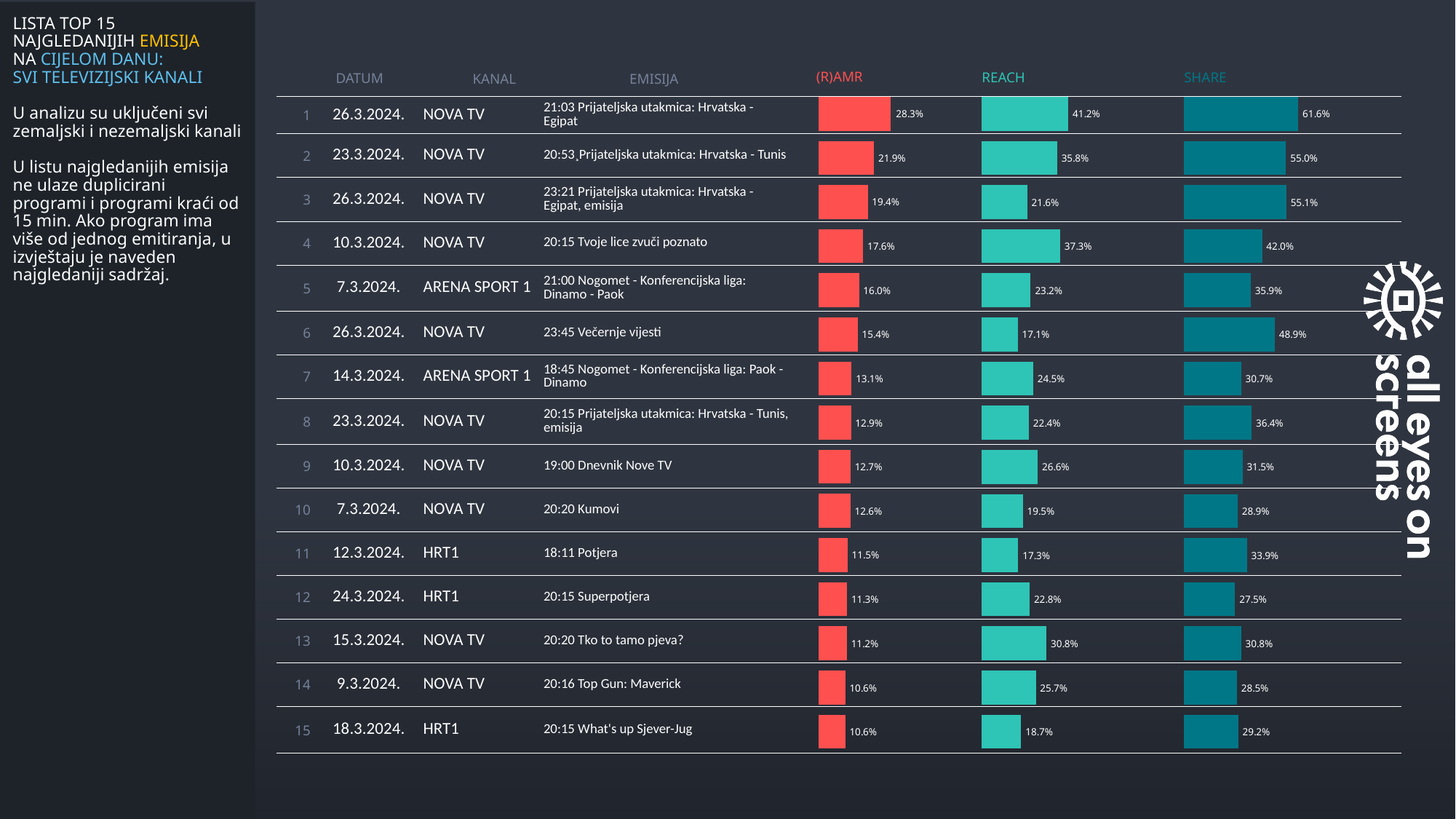
What kind of chart is used to show the (R)AMR, REACH and SHARE values? Bar chart Which programme has the lowest REACH value? 23:45 Večernje vijesti What is the (R)AMR value for the programme ranked 1, 21:03 Prijateljska utakmica: Hrvatska - Egipat? 28.3% What colour are the bars in the (R)AMR column? Red Which programme has the highest SHARE value? 21:03 Prijateljska utakmica: Hrvatska - Egipat What is the SHARE value for 23:45 Večernje vijesti? 48.9% How many programmes are listed in the table? 15 Which channel broadcast the programme ranked 11, 18:11 Potjera? HRT1 Which has a higher REACH value: 20:20 Kumovi or 20:16 Top Gun: Maverick? 20:16 Top Gun: Maverick What is the REACH value for 20:15 Tvoje lice zvuči poznato? 37.3% What is the difference in (R)AMR between the programme ranked 1 (28.3%) and the programme ranked 2 (21.9%)? 6.4% What is the REACH value for 20:20 Tko to tamo pjeva? 30.8%